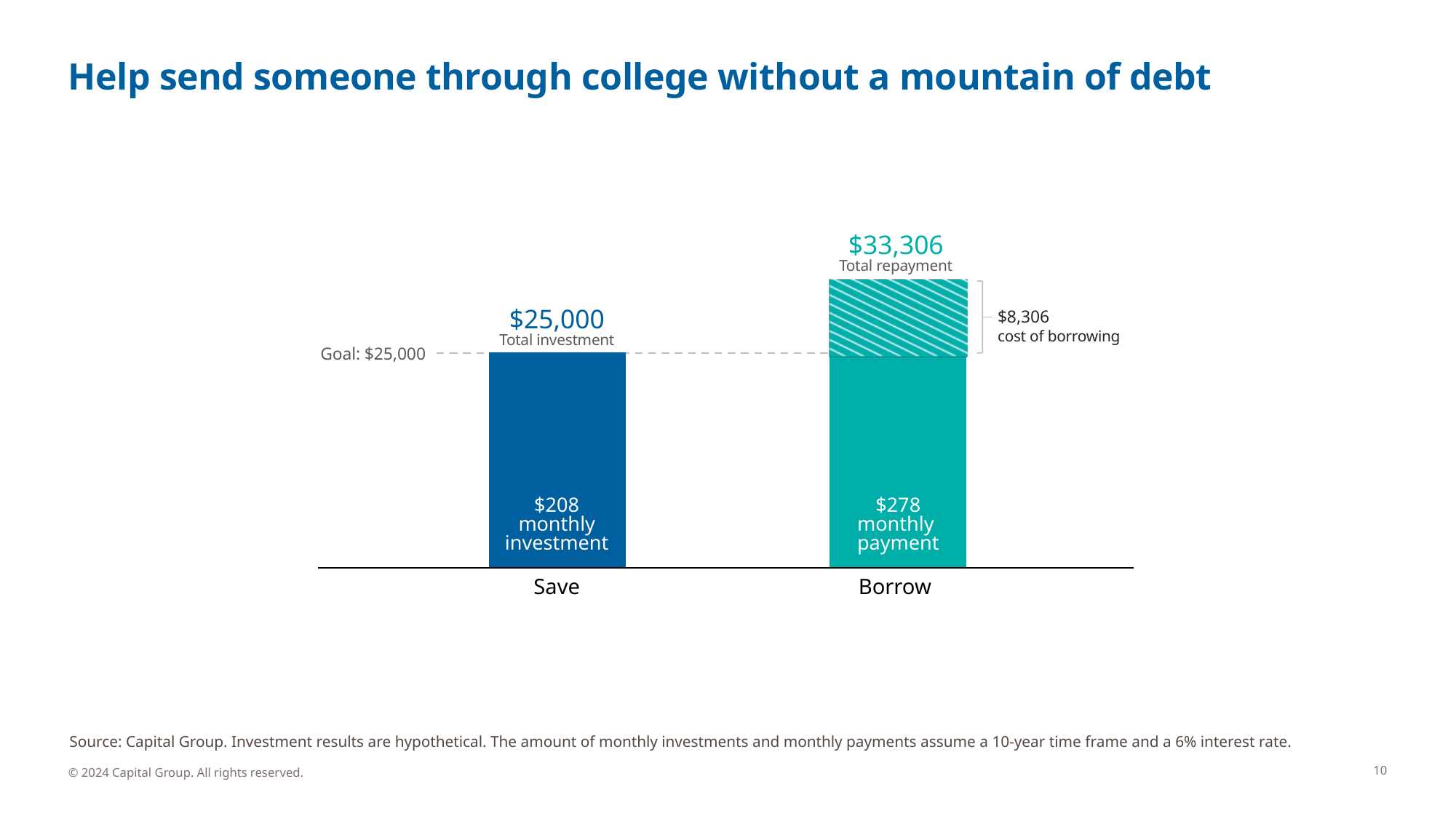
What kind of chart is shown on the slide? bar chart What monthly payment is shown on the Borrow bar? $278 What is the difference between the Borrow total repayment and the Save total investment? $8,306 Is the monthly payment for Borrow larger or smaller than the monthly investment for Save? larger Which bar is taller, Save or Borrow? Borrow What monthly investment is shown on the Save bar? $208 Which bar has the lower total, Save or Borrow? Save What is the cost of borrowing shown next to the Borrow bar? $8,306 What is the total repayment shown for the Borrow bar? $33,306 What is the total investment shown for the Save bar? $25,000 What goal value is marked by the dashed line? $25,000 How many bars are shown in the chart? 2